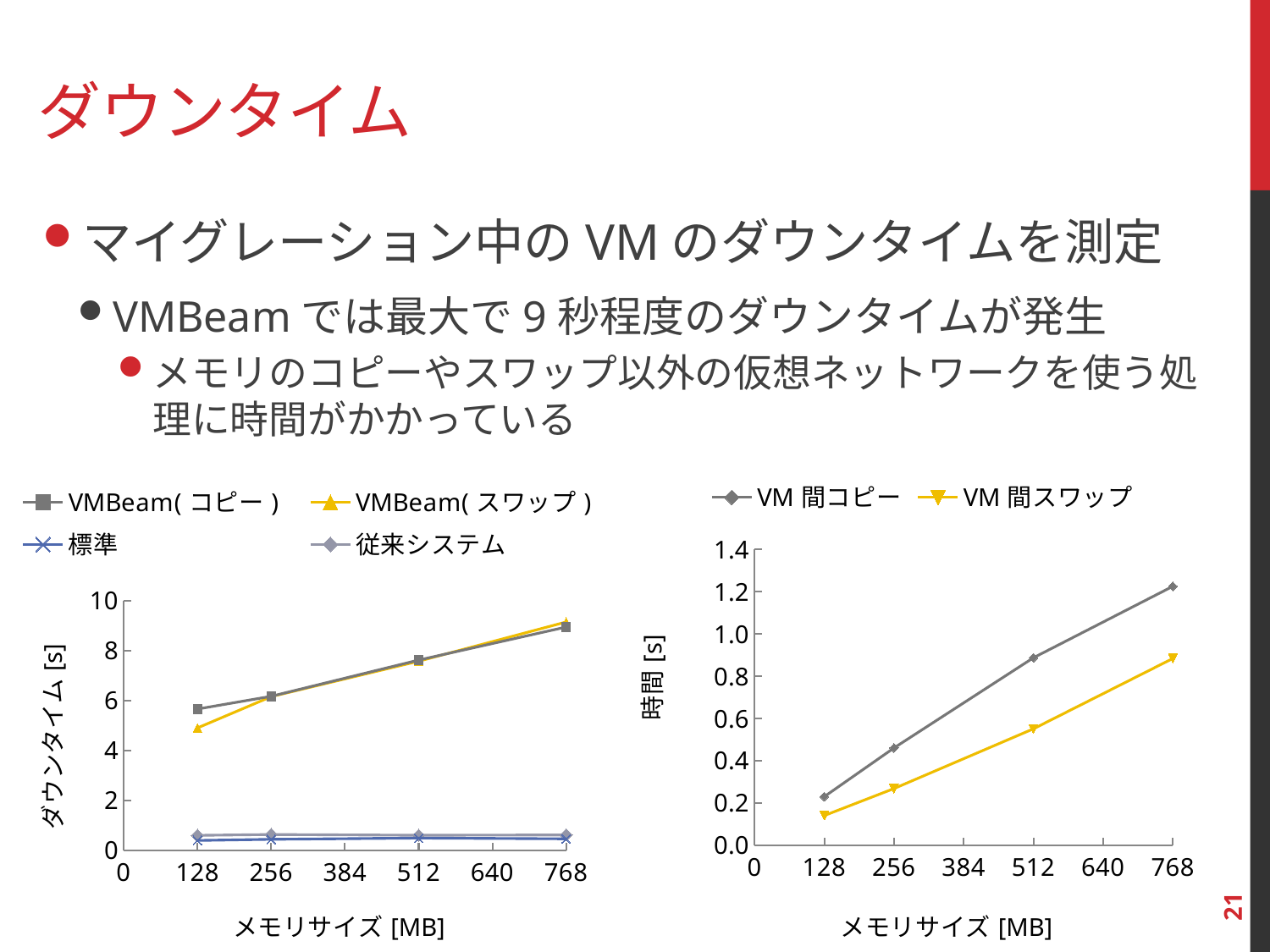
What kind of chart is the left chart (ダウンタイム [s])? line chart In the left chart (ダウンタイム [s]), is the value for VMBeam( スワップ ) at 768 MB greater or less than 8? greater In the left chart (ダウンタイム [s]), is the value for VMBeam( コピー ) at 128 MB greater or less than 4? greater In the right chart (時間 [s]), is the value for VM 間コピー at 768 MB greater or less than 1.0? greater How many series does the legend of the left chart (ダウンタイム [s]) list? 4 In the left chart (ダウンタイム [s]), which is larger at 512 MB: VMBeam( コピー ) or 従来システム? VMBeam( コピー ) How many data points does the VM 間スワップ series have in the right chart (時間 [s])? 4 In the right chart (時間 [s]), which is larger at 512 MB: VM 間コピー or VM 間スワップ? VM 間コピー How many series does the legend of the right chart (時間 [s]) list? 2 In the right chart (時間 [s]), does the VM 間コピー series rise or fall as memory size increases? rise